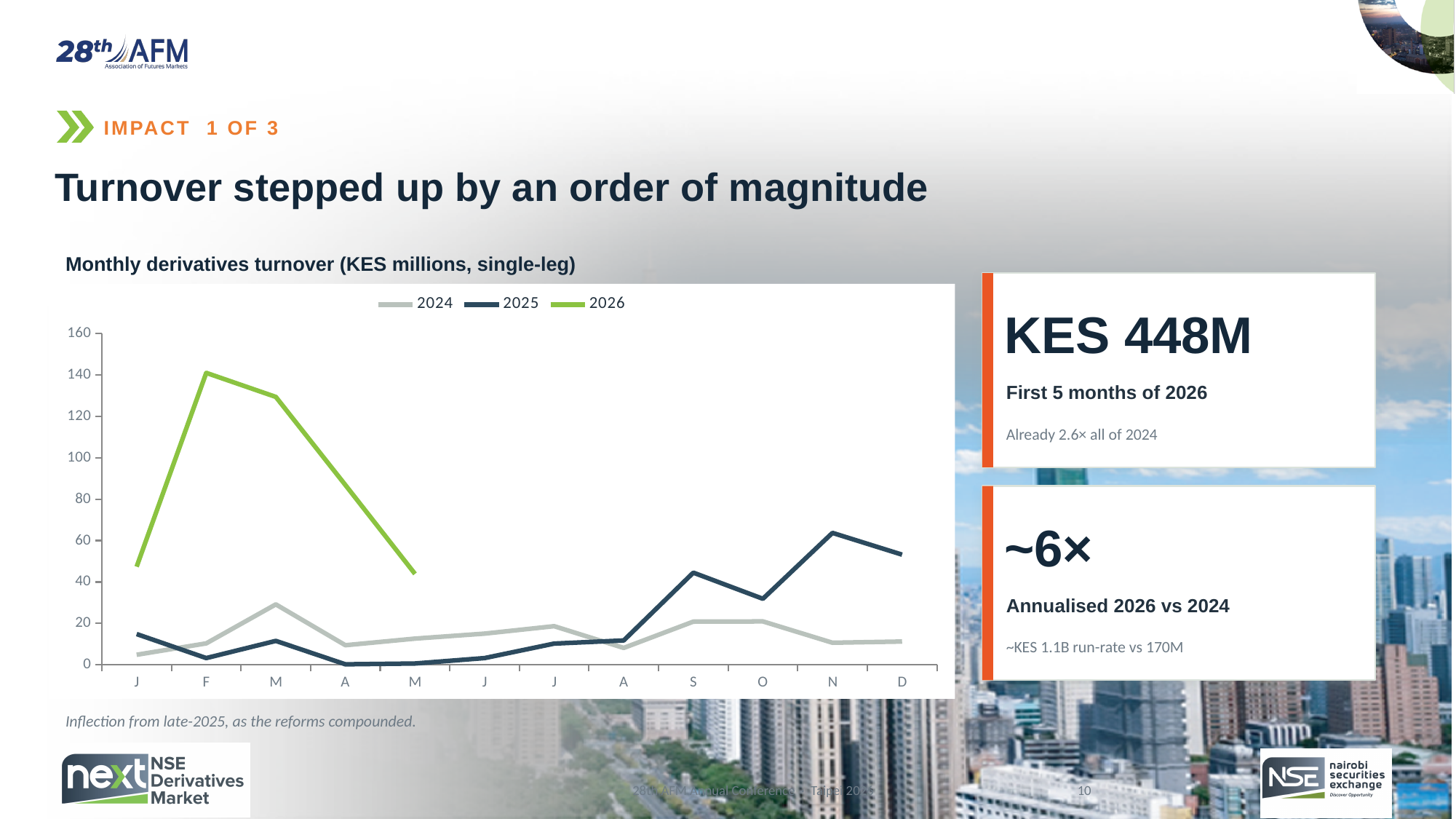
Is the 2024 value for March greater or less than 40? less In which month does the 2026 line reach its highest value? F Is the 2025 value for November greater or less than 40? greater Does the 2026 line rise or fall from February to May? Fall What kind of chart is shown on the slide? Line chart Is the 2026 value for February greater or less than 120? greater In which month does the 2024 line reach its highest value? M (March) Which is larger in January: the 2026 value or the 2025 value? 2026 How many months are shown along the x axis of the chart? 12 What is the title of the chart? Monthly derivatives turnover (KES millions, single-leg) In which month does the 2025 line reach its highest value? N How many series does the chart legend list? 3